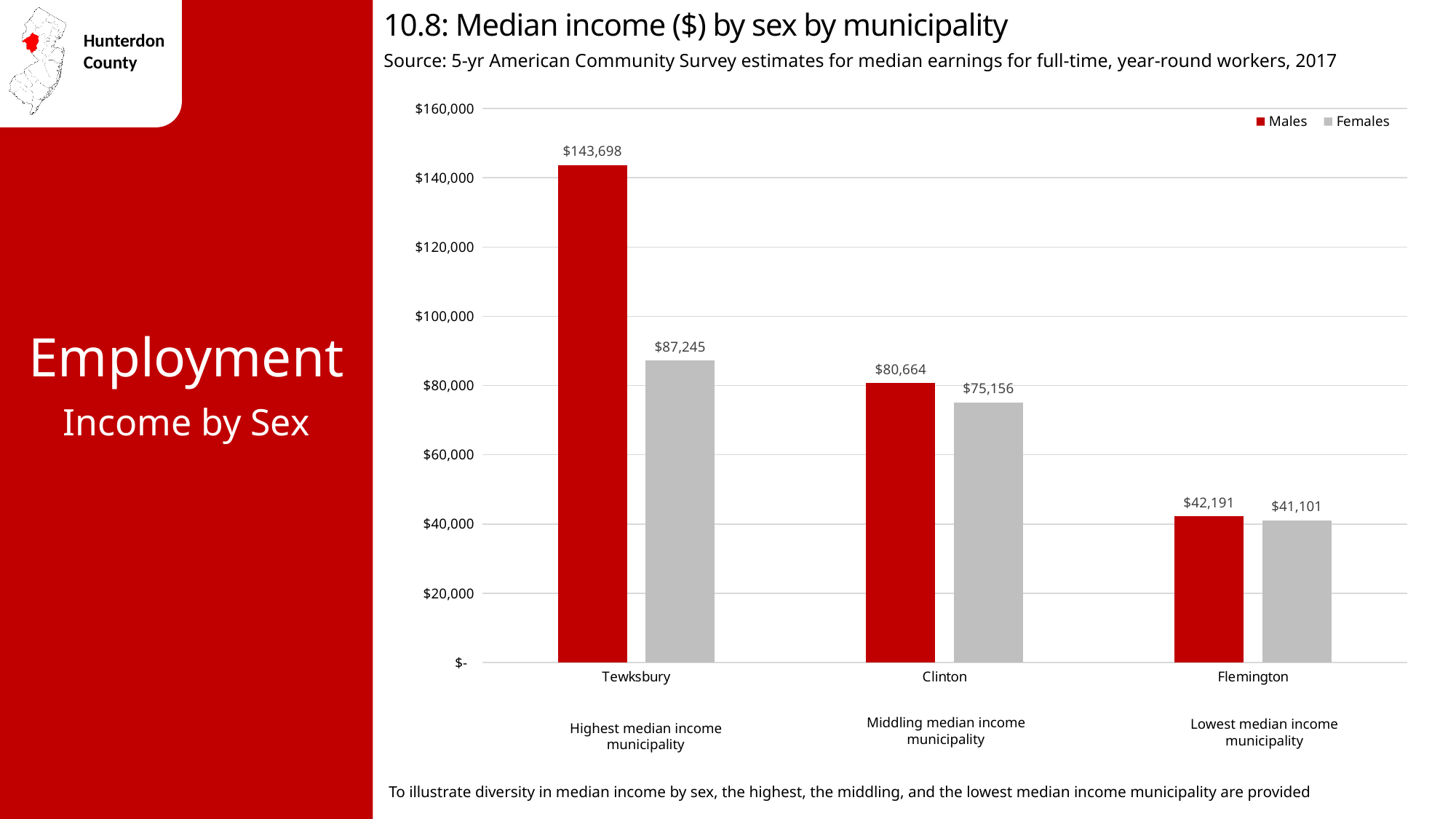
Which is larger, the female median income in Tewksbury or the male median income in Clinton? Female median income in Tewksbury What is the median income for females in Flemington? $41,101 Which municipality has the lowest median income for females? Flemington What kind of chart is shown on the slide? Bar chart What is the median income for males in Tewksbury? $143,698 What is the difference between male and female median income in Clinton? $5,508 Is the male median income in Flemington greater or less than $40,000? greater Which municipality has the highest median income for males? Tewksbury What is the difference between male and female median income in Tewksbury? $56,453 What is the median income for females in Clinton? $75,156 How many municipalities are shown on the chart? 3 How many series does the legend list? 2